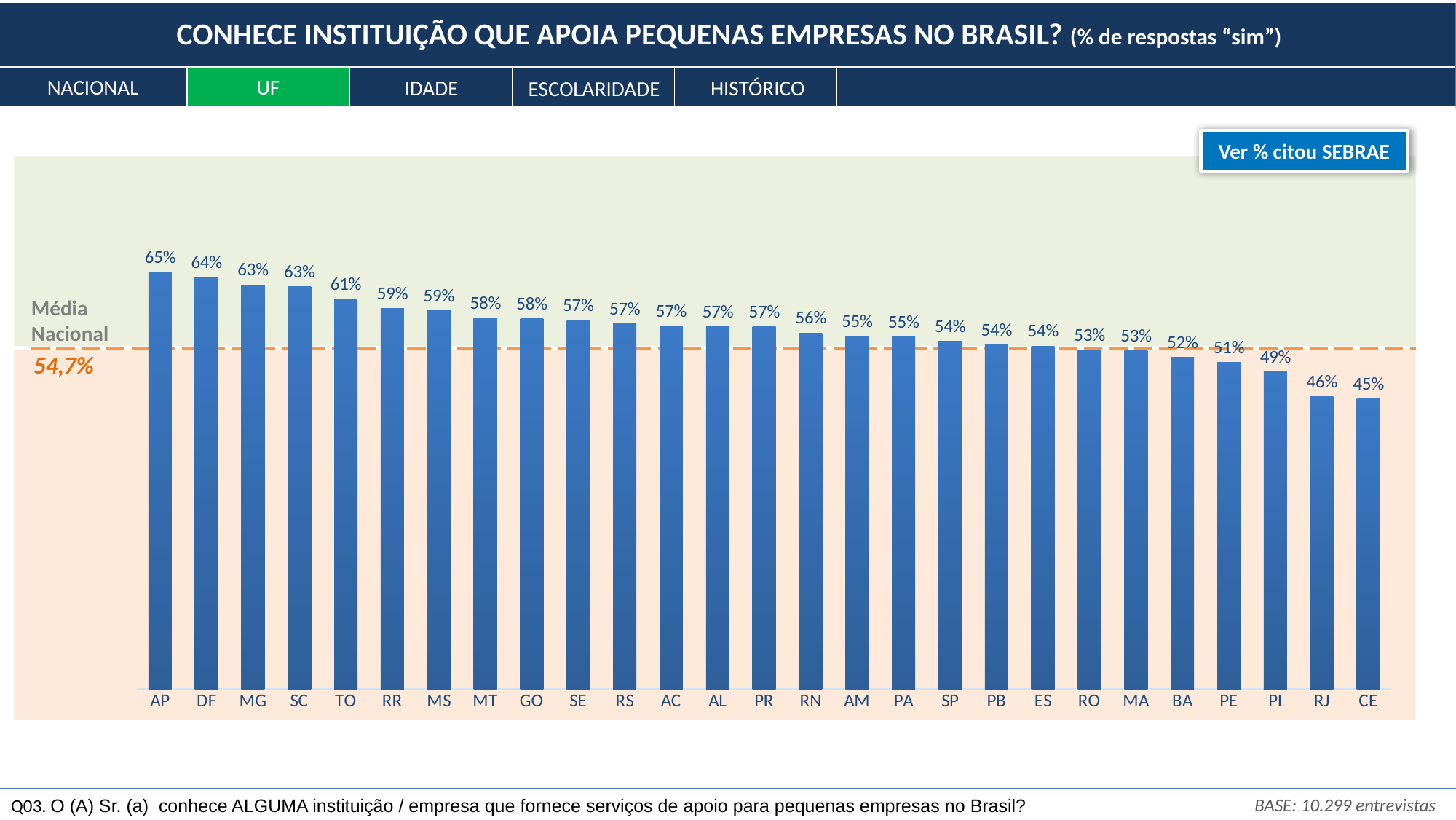
What kind of chart is shown on the slide? Bar chart What is the value for SP? 54% What is the value for TO? 61% What is the value for RJ? 46% How many states (UFs) are shown in the chart? 27 What is the difference between the values for AP and CE? 20% What is the value of the 'Média Nacional' line shown on the chart? 54,7% Which state (UF) has the highest value? AP Which has a larger value, DF or PE? DF Do the values rise or fall from left to right along the x axis? Fall What is the value for AP? 65% Which state (UF) has the lowest value? CE